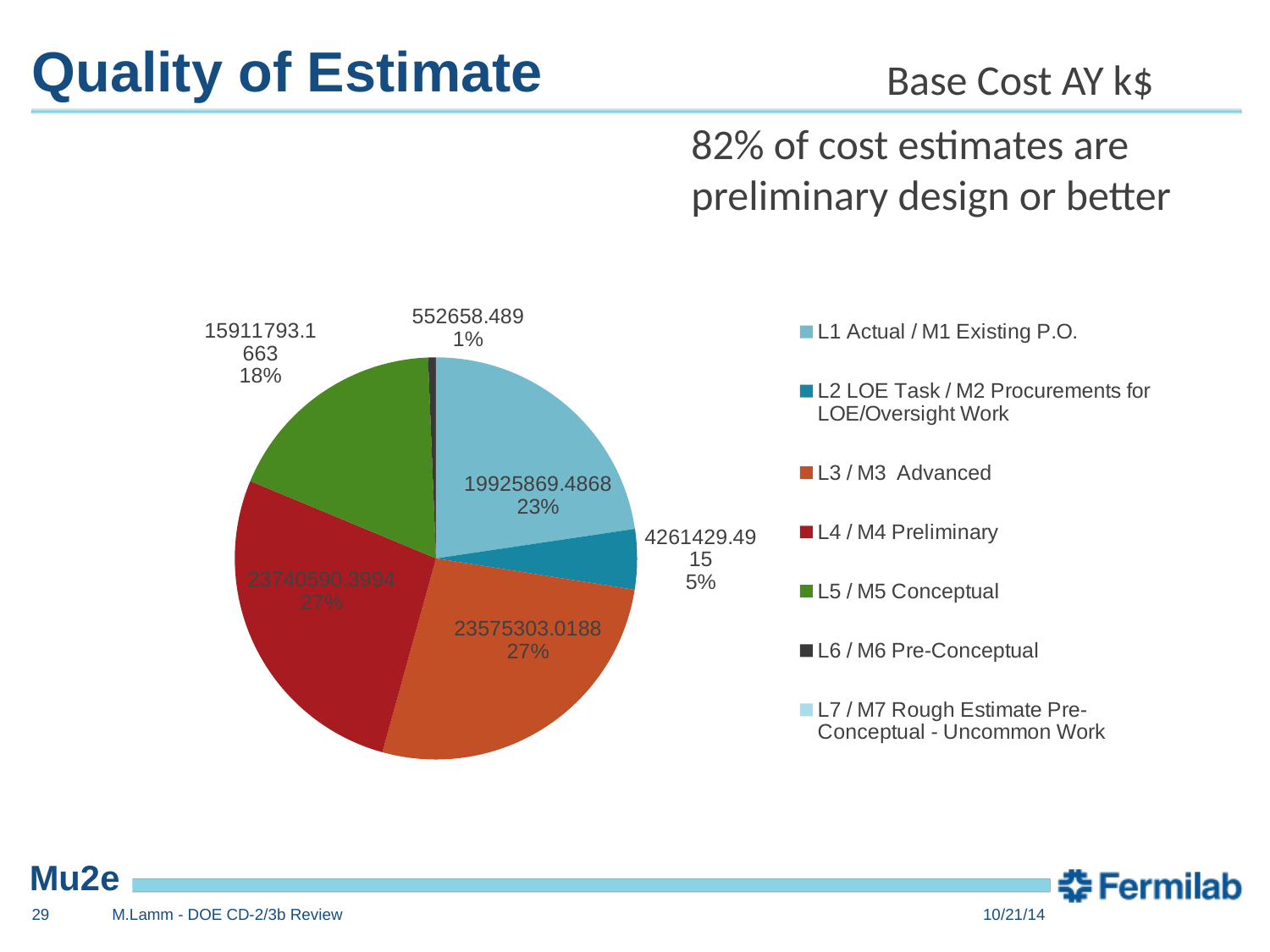
What kind of chart is shown on the slide? pie chart What is the value labelled on the L6 / M6 Pre-Conceptual slice? 552658.489 What is the difference between the labelled values of L4 / M4 Preliminary and L3 / M3 Advanced? 165287.3806 What share of the pie does the L5 / M5 Conceptual slice represent? 18% Which has the larger labelled value, L1 Actual / M1 Existing P.O. or L5 / M5 Conceptual? L1 Actual / M1 Existing P.O. Which category has the smallest visible slice of the pie? L6 / M6 Pre-Conceptual What is the value labelled on the L4 / M4 Preliminary slice? 23740590.3994 What share of the pie does the L1 Actual / M1 Existing P.O. slice represent? 23% What share of the pie does the L2 LOE Task / M2 Procurements for LOE/Oversight Work slice represent? 5% What is the value labelled on the L3 / M3 Advanced slice? 23575303.0188 What colour is the L5 / M5 Conceptual slice? green How many categories are listed in the chart's legend? 7